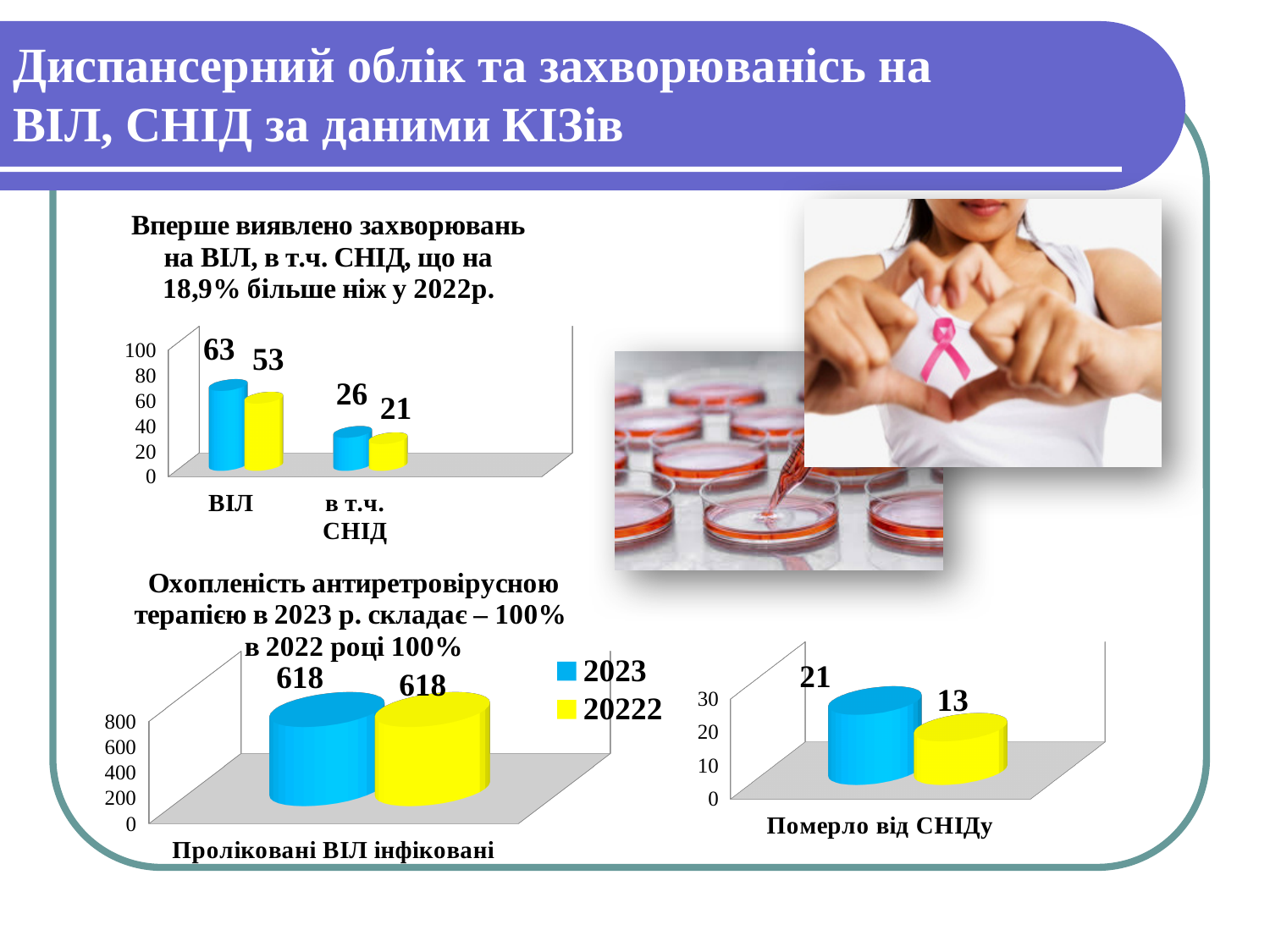
What kind of chart is the one titled Померло від СНІДу? Bar chart In the top-left chart, what is the value of the blue bar for в т.ч. СНІД? 26 In the chart titled Проліковані ВІЛ інфіковані, what is the value of the blue bar? 618 In the chart titled Померло від СНІДу, what is the difference between the blue and yellow bars? 8 In the top-left chart, how many categories are shown on the x axis? 2 In the top-left chart, what is the value of the blue bar for ВІЛ? 63 In the chart titled Померло від СНІДу, what is the value of the blue bar? 21 In the top-left chart, what is the difference between the blue and yellow bars for ВІЛ? 10 In the chart titled Проліковані ВІЛ інфіковані, what is the value of the yellow bar? 618 In the top-left chart, what is the value of the yellow bar for ВІЛ? 53 In the top-left chart, which category has the highest value? ВІЛ In the top-left chart, what is the value of the yellow bar for в т.ч. СНІД? 21